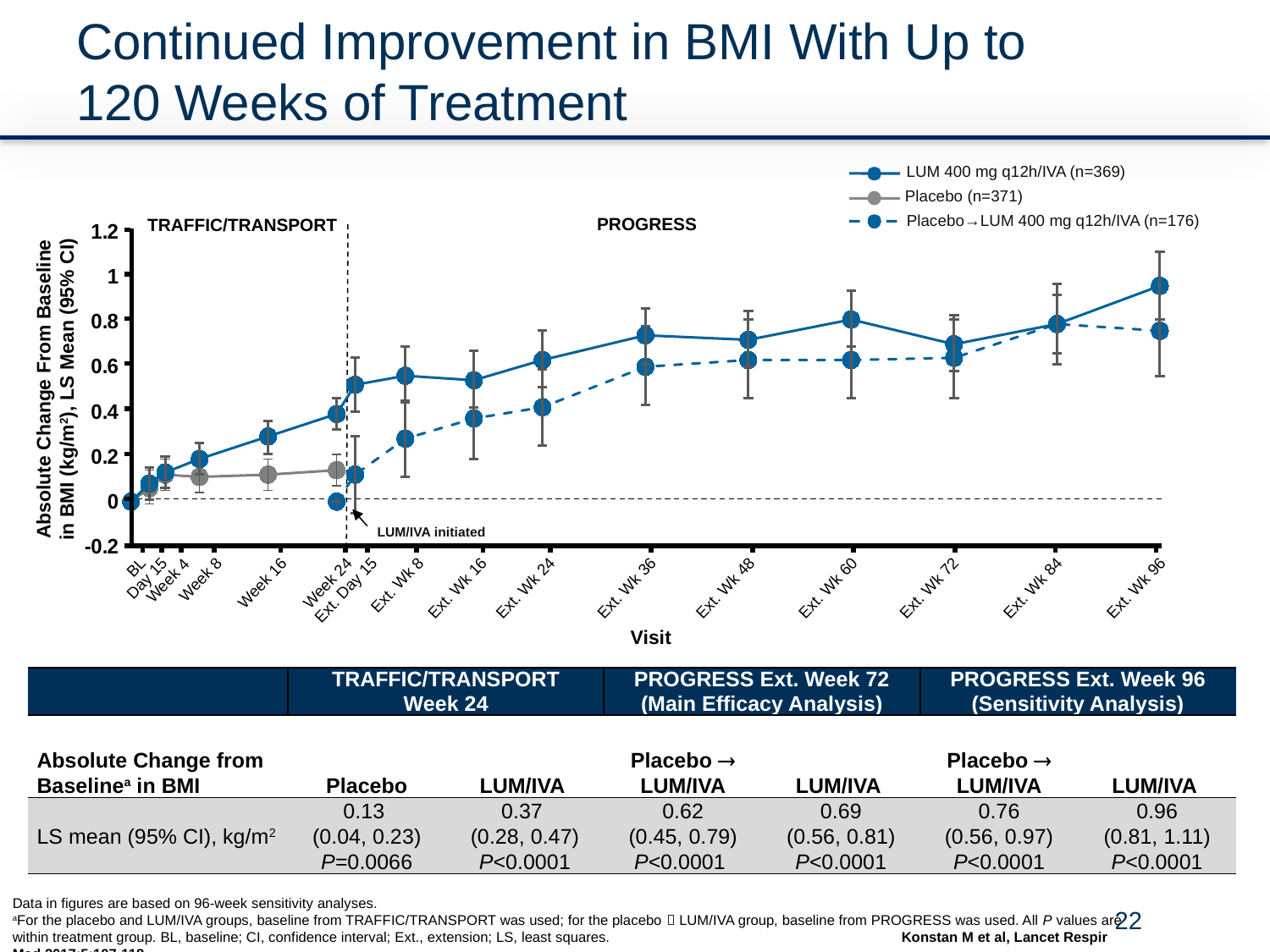
According to the legend, how many patients are in the Placebo group? 371 Is the value for Placebo→LUM 400 mg q12h/IVA at Ext. Day 15 greater or less than 0.2? less At which visit does the LUM 400 mg q12h/IVA series reach its highest value? Ext. Wk 96 How many series does the chart legend list? 3 What kind of chart is shown on the slide? line chart Is the value for LUM 400 mg q12h/IVA at Ext. Wk 96 greater or less than 0.8? greater At Ext. Wk 24, which series has the larger value: LUM 400 mg q12h/IVA or Placebo→LUM 400 mg q12h/IVA? LUM 400 mg q12h/IVA Does the LUM 400 mg q12h/IVA series generally rise or fall from BL to Ext. Wk 96? rise Is the value for LUM 400 mg q12h/IVA at Ext. Wk 36 greater or less than 0.6? greater How many visits are labelled along the x axis of the chart? 16 Which series in the legend is drawn with a dashed line? Placebo→LUM 400 mg q12h/IVA (n=176)